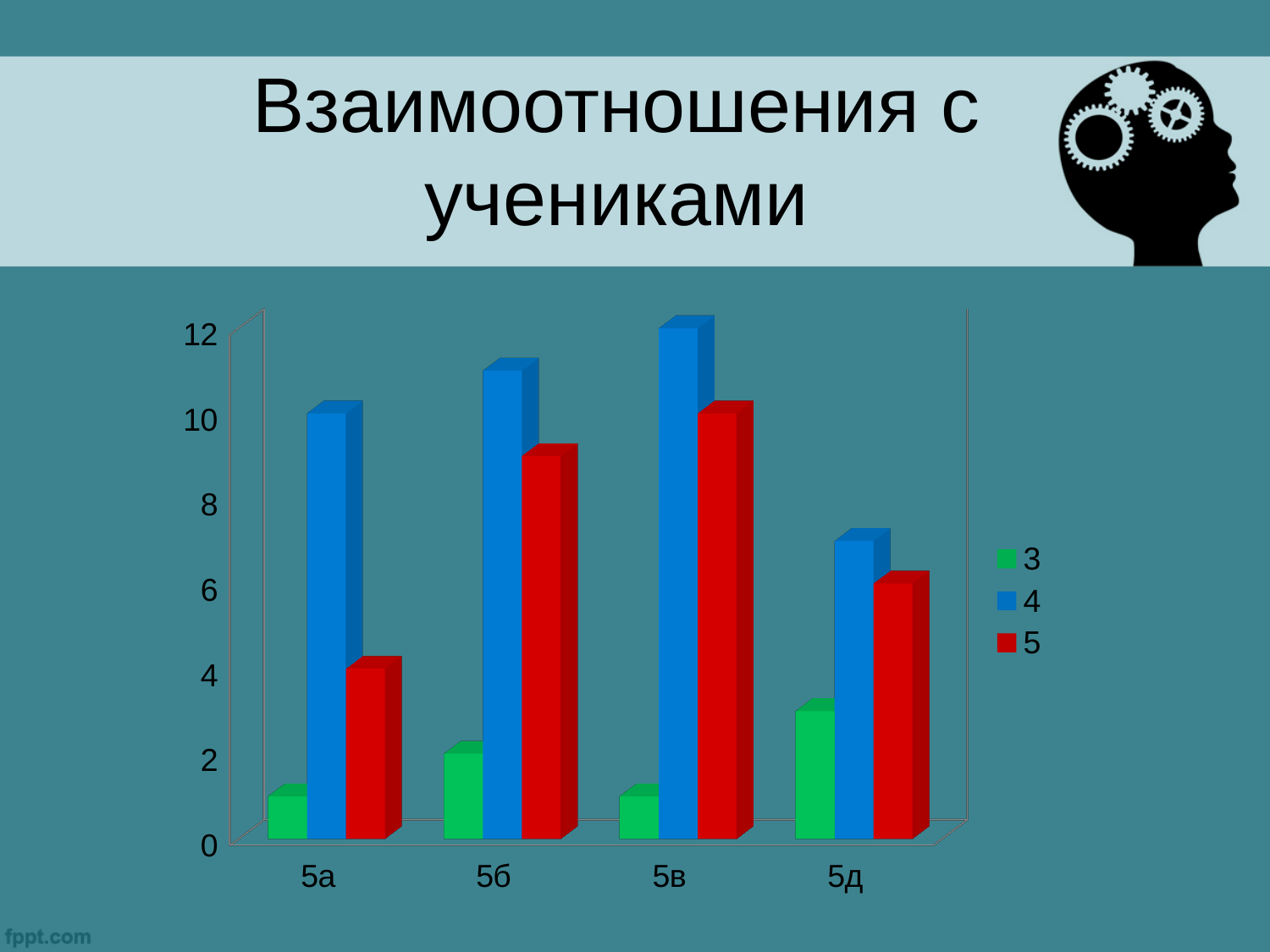
Which category has the highest value for series 4? 5в What is the title of the slide containing the chart? Взаимоотношения с учениками Which category has the highest value for series 3? 5д Which category has the lowest value for series 4? 5д Is the value for series 5 in category 5а greater or less than 6? less Is the value for series 4 in category 5б greater or less than 10? greater For category 5б, which is larger: series 4 or series 5? series 4 How many series does the chart legend list? 3 Is the value for series 3 in category 5д greater or less than 4? less How many categories are shown on the x axis of the chart? 4 What kind of chart is shown on the slide? bar chart Which category has the lowest value for series 5? 5а